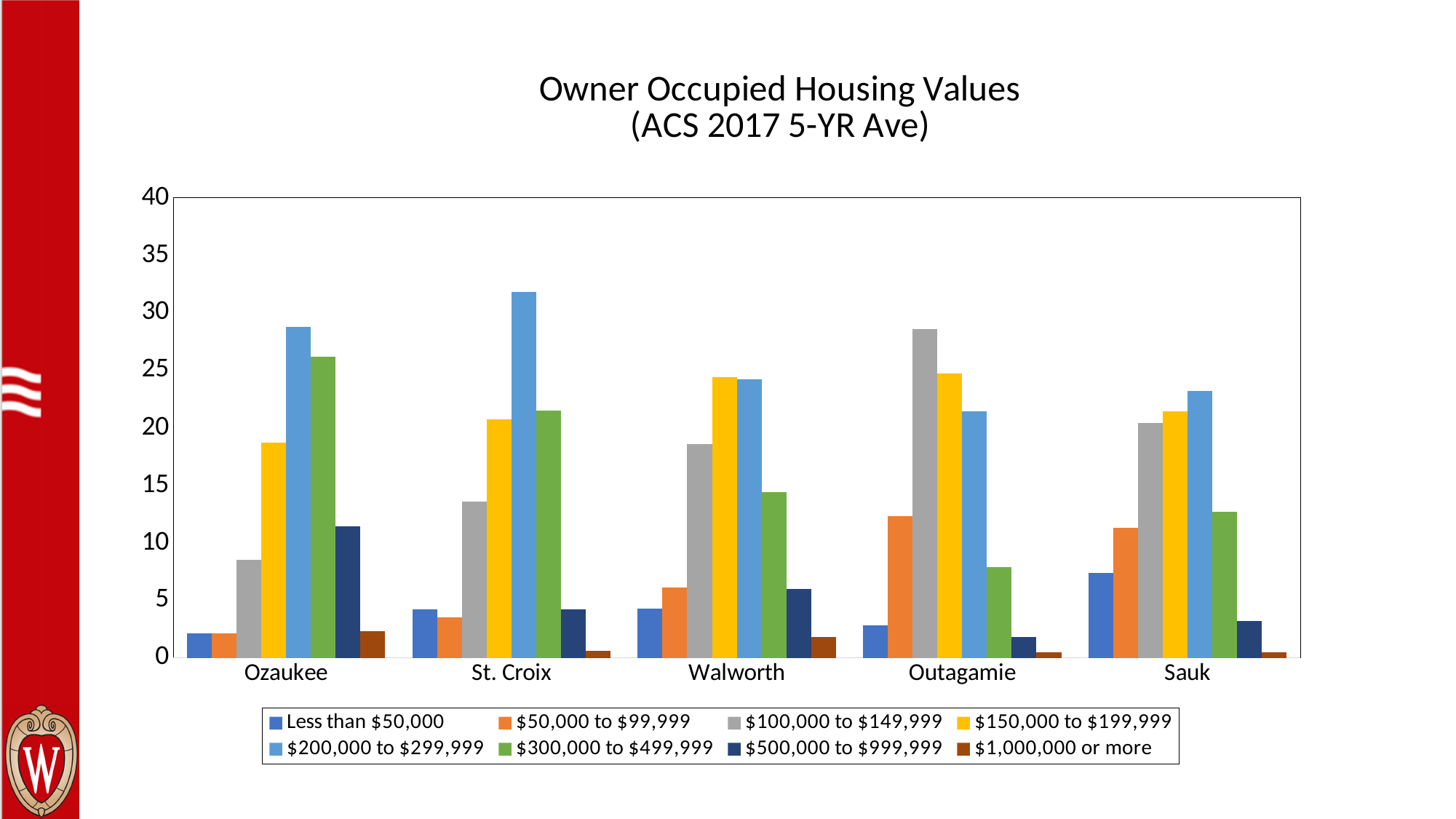
How many counties are shown on the x axis of the chart? 5 Which county has the highest bar for the $200,000 to $299,999 series? St. Croix Which is larger: the $300,000 to $499,999 value for Ozaukee or for Walworth? Ozaukee Is the value for $300,000 to $499,999 in Sauk greater or less than 15? less Is the value for $200,000 to $299,999 in St. Croix greater or less than 30? greater How many housing value series does the legend list? 8 Which county has the highest bar for the Less than $50,000 series? Sauk What is the title of the chart? Owner Occupied Housing Values (ACS 2017 5-YR Ave) Which county has the highest bar for the $100,000 to $149,999 series? Outagamie Is the value for $200,000 to $299,999 in Ozaukee greater or less than 25? greater What kind of chart is shown on the slide? bar chart